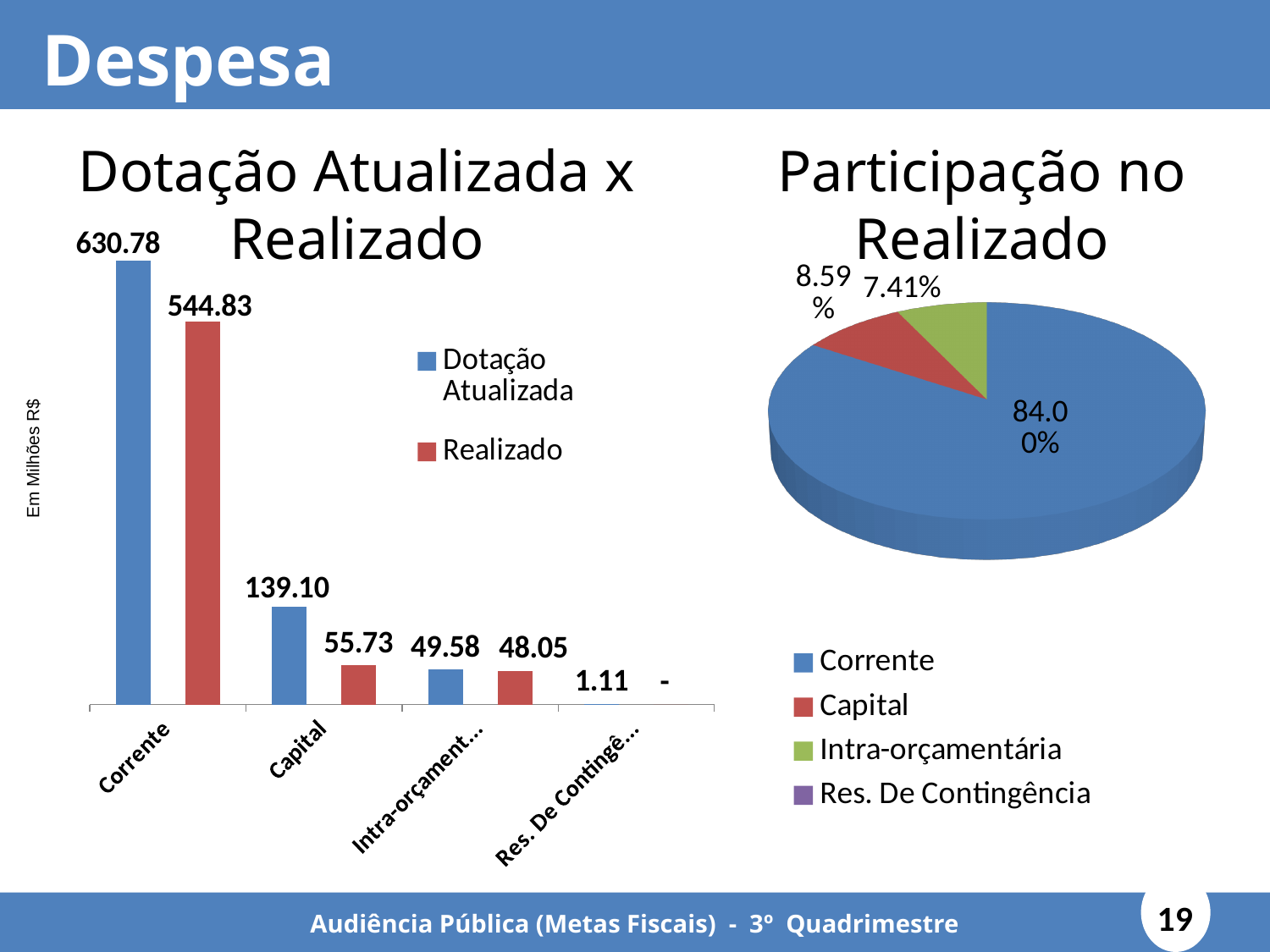
How many categories are shown on the x axis of the 'Dotação Atualizada x Realizado' chart? 4 In the 'Dotação Atualizada x Realizado' bar chart, which category has the highest Realizado value? Corrente In the 'Dotação Atualizada x Realizado' bar chart, what is the Realizado value for Capital? 55.73 In the 'Participação no Realizado' pie chart, which slice is larger: Capital or Intra-orçamentária? Capital In the 'Dotação Atualizada x Realizado' bar chart, what is the difference between Dotação Atualizada and Realizado for Corrente? 85.95 In the 'Dotação Atualizada x Realizado' bar chart, what is the Dotação Atualizada value for Corrente? 630.78 What kind of chart is 'Dotação Atualizada x Realizado'? Bar chart In the 'Participação no Realizado' pie chart, what share does Corrente have? 84.00% In the 'Dotação Atualizada x Realizado' bar chart, which is larger for Capital: Dotação Atualizada or Realizado? Dotação Atualizada In the 'Participação no Realizado' pie chart, what share does Capital have? 8.59% What unit label is shown on the vertical axis of the 'Dotação Atualizada x Realizado' chart? Em Milhões R$ How many series does the legend of the 'Dotação Atualizada x Realizado' bar chart list? 2